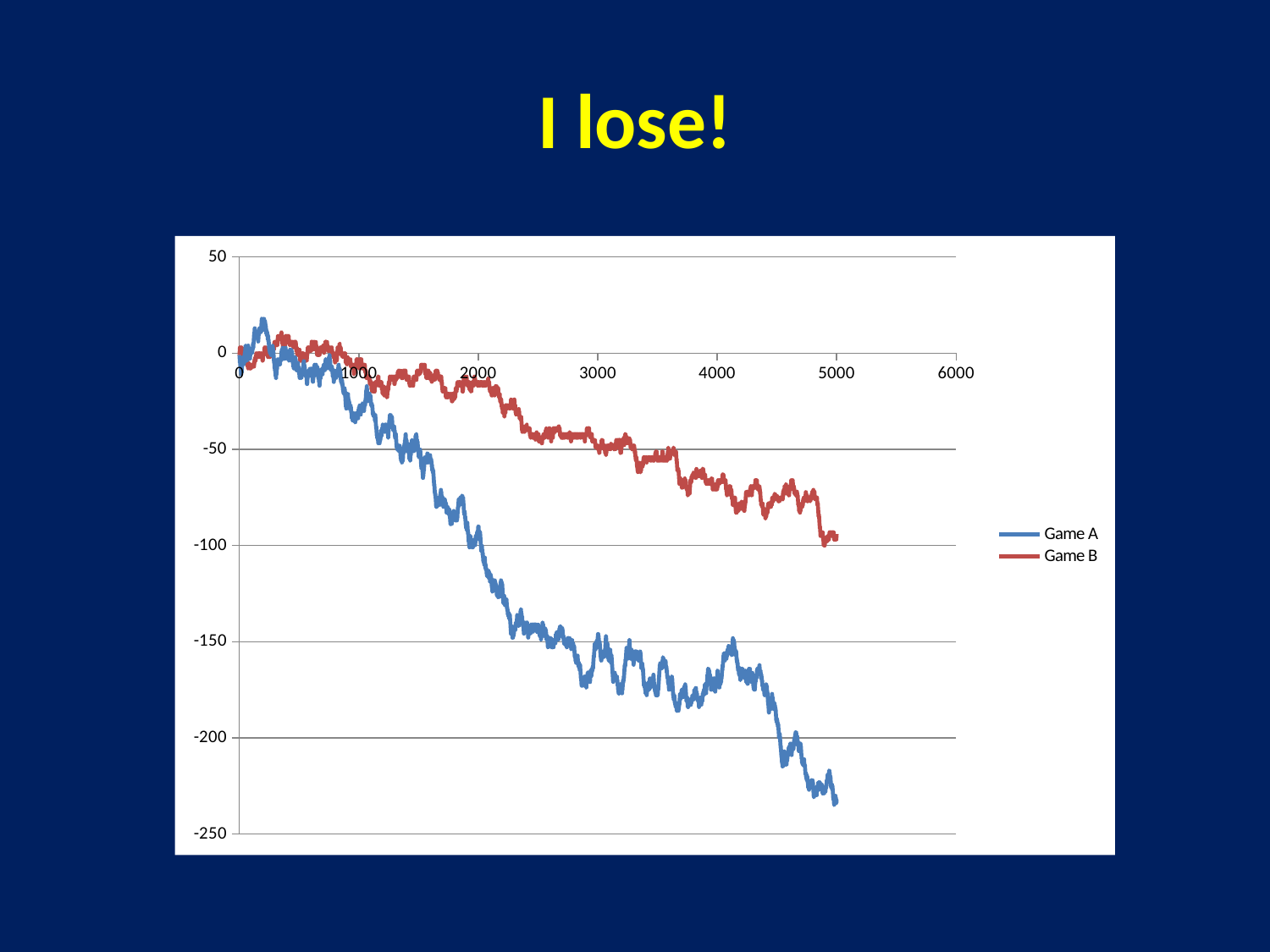
Which colour is used for the Game A line? blue Do the values for Game A rise or fall as the x axis increases? fall How many series does the legend list? 2 Which series ends at a lower value at the right end of the chart, Game A or Game B? Game A Is the value for Game B at x = 4000 greater or less than -50? less Do the values for Game B rise or fall as the x axis increases? fall Is the value for Game A at x = 5000 greater or less than -200? less What are the names of the two series in the legend? Game A and Game B At x = 4000, which series has the higher value, Game A or Game B? Game B What kind of chart is shown on the slide? line chart Is the value for Game B at x = 4000 greater or less than -100? greater